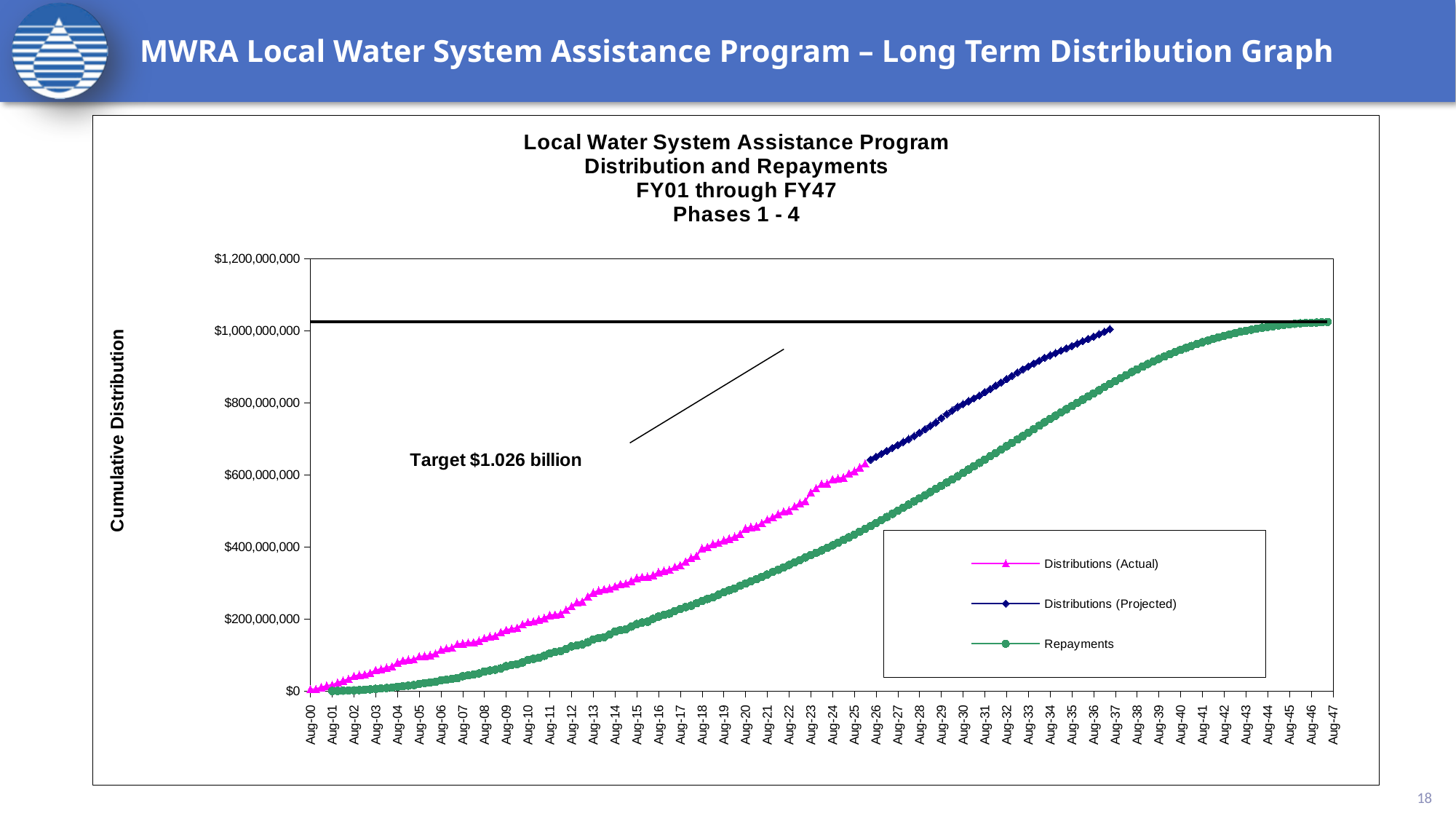
At Aug-20, which is larger: Distributions (Actual) or Repayments? Distributions (Actual) Is the Repayments value at Aug-40 greater or less than $800,000,000? greater Is the Repayments value at Aug-20 greater or less than $400,000,000? less Is the Distributions (Actual) value at Aug-25 greater or less than $400,000,000? greater What is the title of the vertical axis? Cumulative Distribution Do the Repayments values rise or fall from Aug-00 to Aug-47? rise How many series does the legend list? 3 Which series reaches the target line last, at Aug-47? Repayments What target value is annotated on the chart? Target $1.026 billion What kind of chart is shown on the slide? line chart